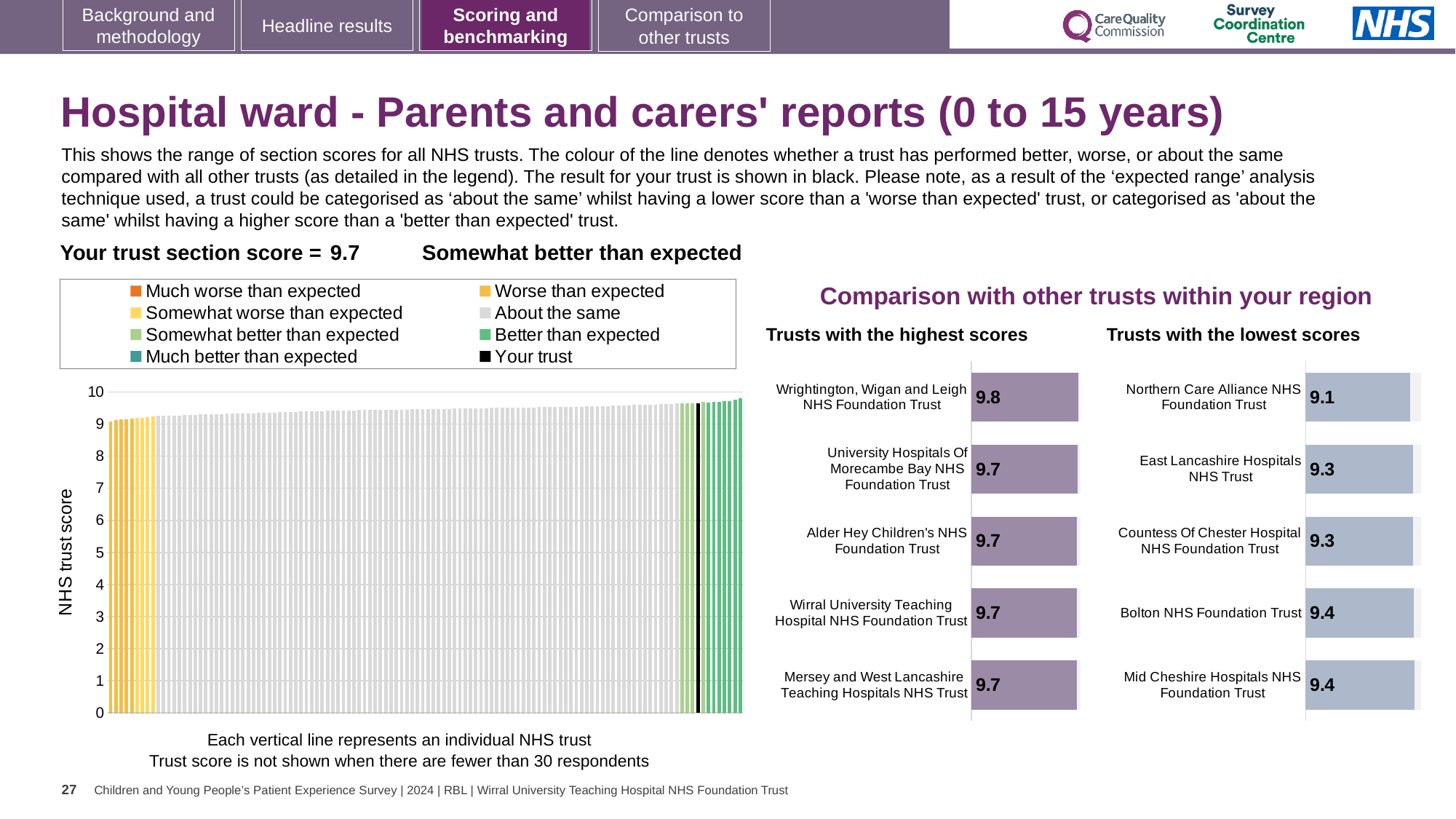
In the large chart on the left, how many entries does the legend list? 8 In the large chart on the left, what is the label on the vertical axis? NHS trust score In the 'Trusts with the lowest scores' chart, what is the difference between the score for Bolton NHS Foundation Trust and the score for Northern Care Alliance NHS Foundation Trust? 0.3 In the 'Trusts with the lowest scores' chart, what is the score for Northern Care Alliance NHS Foundation Trust? 9.1 In the 'Trusts with the lowest scores' chart, which trust has the lowest score? Northern Care Alliance NHS Foundation Trust In the 'Trusts with the highest scores' chart, which trust has the highest score? Wrightington, Wigan and Leigh NHS Foundation Trust In the 'Trusts with the highest scores' chart, what is the difference between the score for Wrightington, Wigan and Leigh NHS Foundation Trust and the score for Alder Hey Children's NHS Foundation Trust? 0.1 In the 'Trusts with the highest scores' chart, how many trusts are listed? 5 In the 'Trusts with the lowest scores' chart, what is the score for Mid Cheshire Hospitals NHS Foundation Trust? 9.4 In the 'Trusts with the lowest scores' chart, which has the larger score: East Lancashire Hospitals NHS Trust or Bolton NHS Foundation Trust? Bolton NHS Foundation Trust What kind of chart is the large chart on the left showing NHS trust scores? Bar chart In the 'Trusts with the highest scores' chart, what is the score for Wrightington, Wigan and Leigh NHS Foundation Trust? 9.8